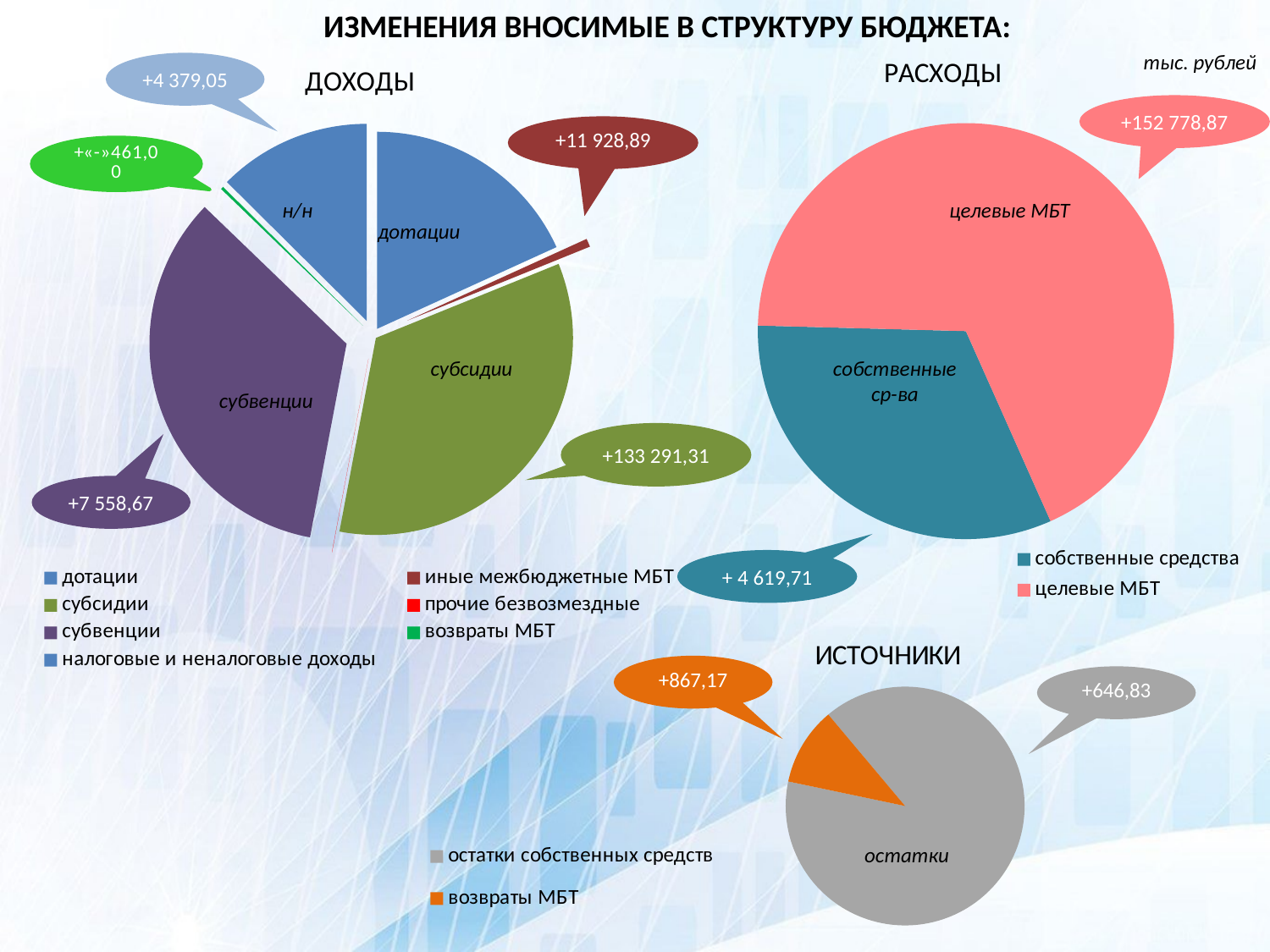
In the РАСХОДЫ chart, what change is shown in the callout for целевые МБТ? +152 778,87 How many entries does the legend of the ДОХОДЫ chart list? 7 In the ИСТОЧНИКИ chart, what is the difference between the callout values for возвраты МБТ (+867,17) and остатки (+646,83)? 220,34 In the ДОХОДЫ chart, what change is shown in the blue callout pointing to the н/н slice? +4 379,05 In the РАСХОДЫ chart, what change is shown in the callout for собственные средства? + 4 619,71 In the ДОХОДЫ chart, what change is shown in the callout for субсидии? +133 291,31 In the ИСТОЧНИКИ chart, what change is shown in the callout for возвраты МБТ? +867,17 In the РАСХОДЫ chart, which slice is the largest? целевые МБТ In the РАСХОДЫ chart, which callout value is larger, целевые МБТ or собственные средства? целевые МБТ What kind of chart is the ДОХОДЫ chart? pie chart In the ИСТОЧНИКИ chart, which slice is the smallest? возвраты МБТ In the ДОХОДЫ chart, what change is shown in the callout for субвенции? +7 558,67